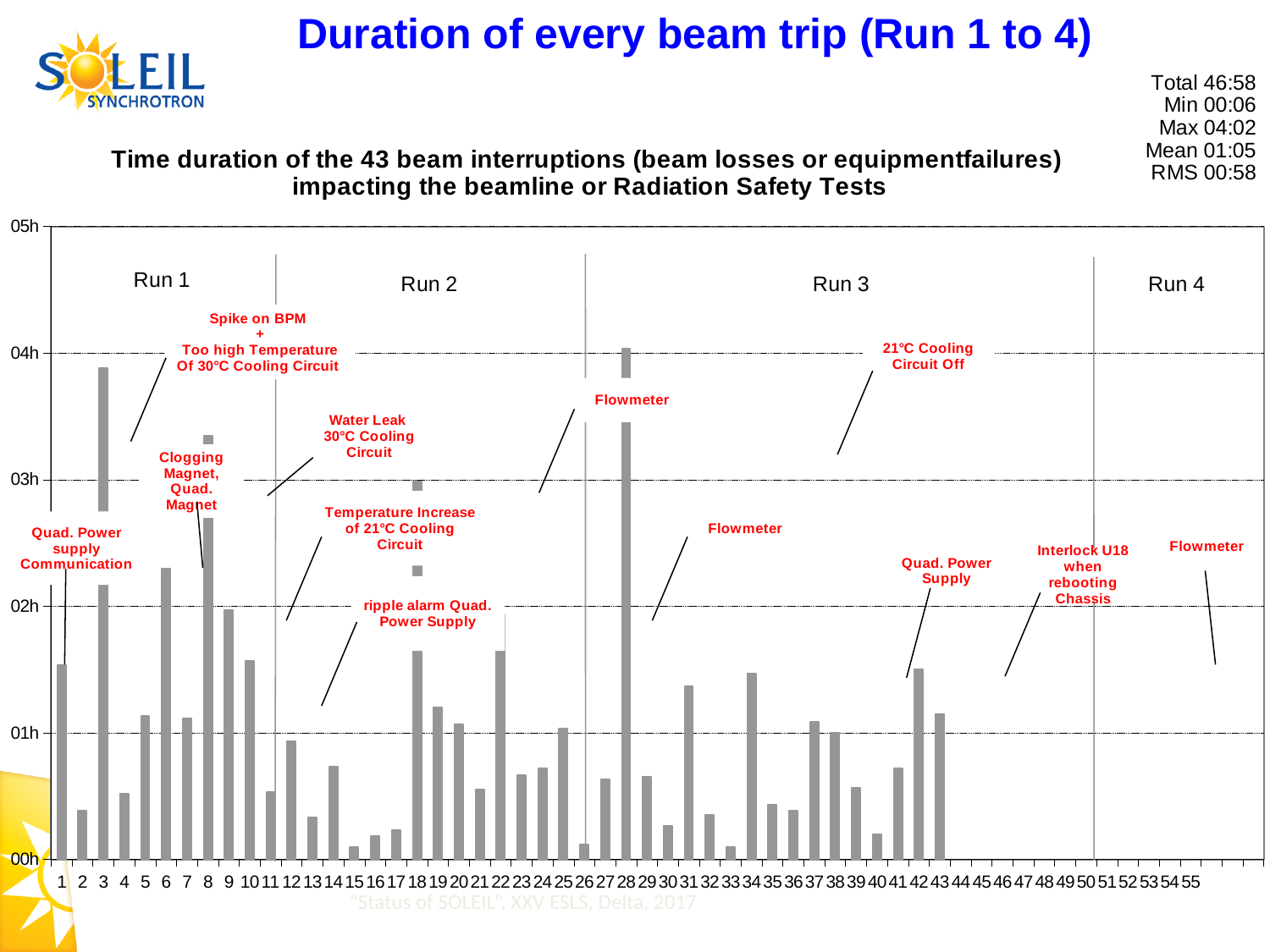
Is the duration of beam trip 8 greater or less than 02h? greater What kind of chart is shown on the slide? bar chart Is the duration of beam trip 1 greater or less than 02h? less How many beam interruptions are plotted in the chart? 43 Which has the longer duration, beam trip 28 or beam trip 34? beam trip 28 Is the duration of beam trip 42 greater or less than 01h? greater Which has the longer duration, beam trip 3 or beam trip 8? beam trip 3 Which beam trip number has the longest duration? 28 What is the maximum beam trip duration stated on the slide? 04:02 What cause is annotated for the tallest bar (beam trip 28)? Flowmeter